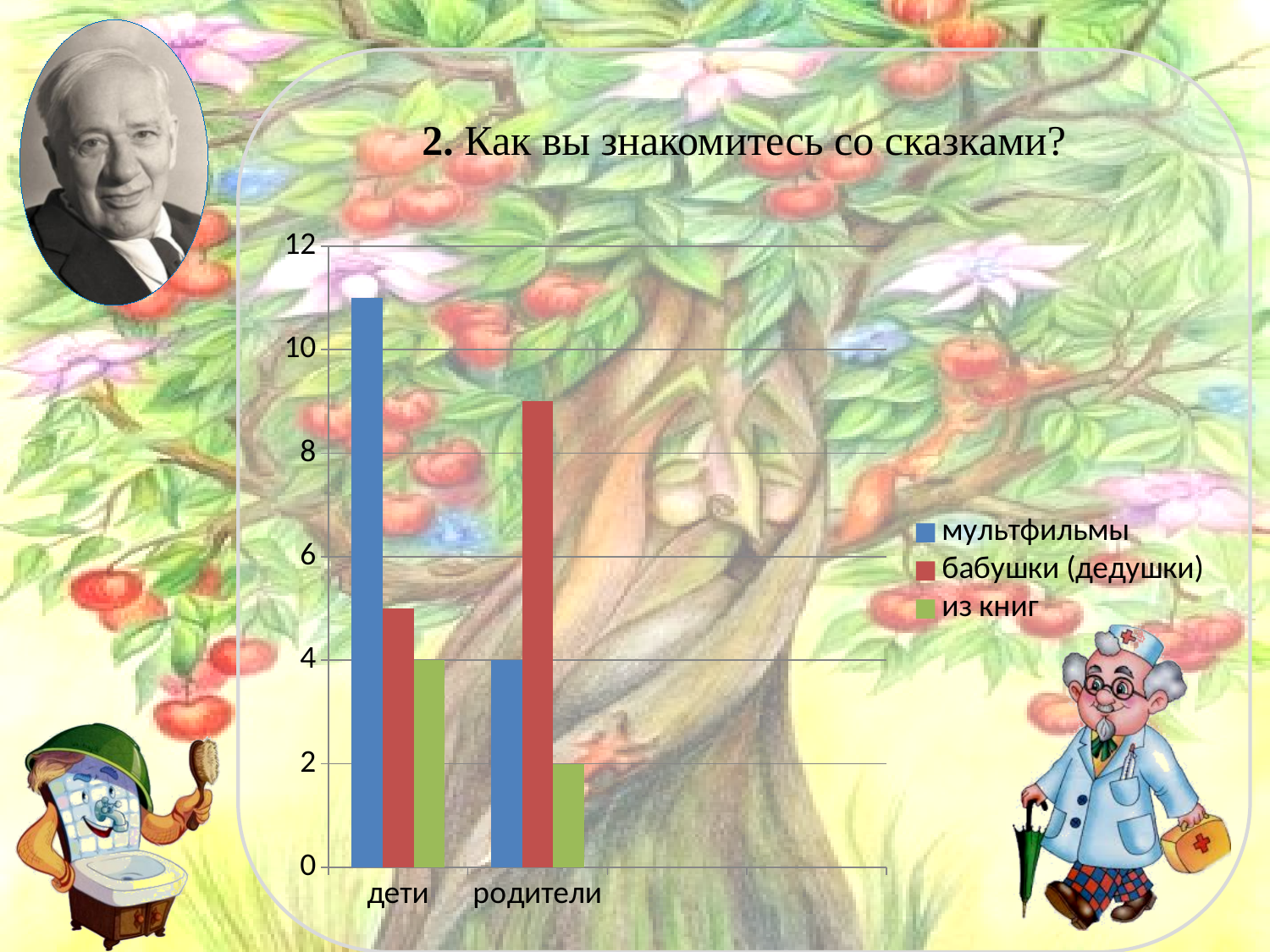
What kind of chart is shown on the slide? bar chart How many categories are shown on the x axis? 2 What is the value for "мультфильмы" in the "родители" category? 4 Which is larger: the "мультфильмы" value for "дети" or for "родители"? дети What is the difference between the "мультфильмы" and "из книг" values in the "родители" category? 2 How many series does the legend list? 3 Which series has the lowest value in the "родители" category? из книг What is the value for "из книг" in the "дети" category? 4 What is the value for "из книг" in the "родители" category? 2 Is the value for "мультфильмы" in the "дети" category greater or less than 10? greater Is the value for "бабушки (дедушки)" in the "родители" category greater or less than 8? greater Which series has the highest value in the "дети" category? мультфильмы